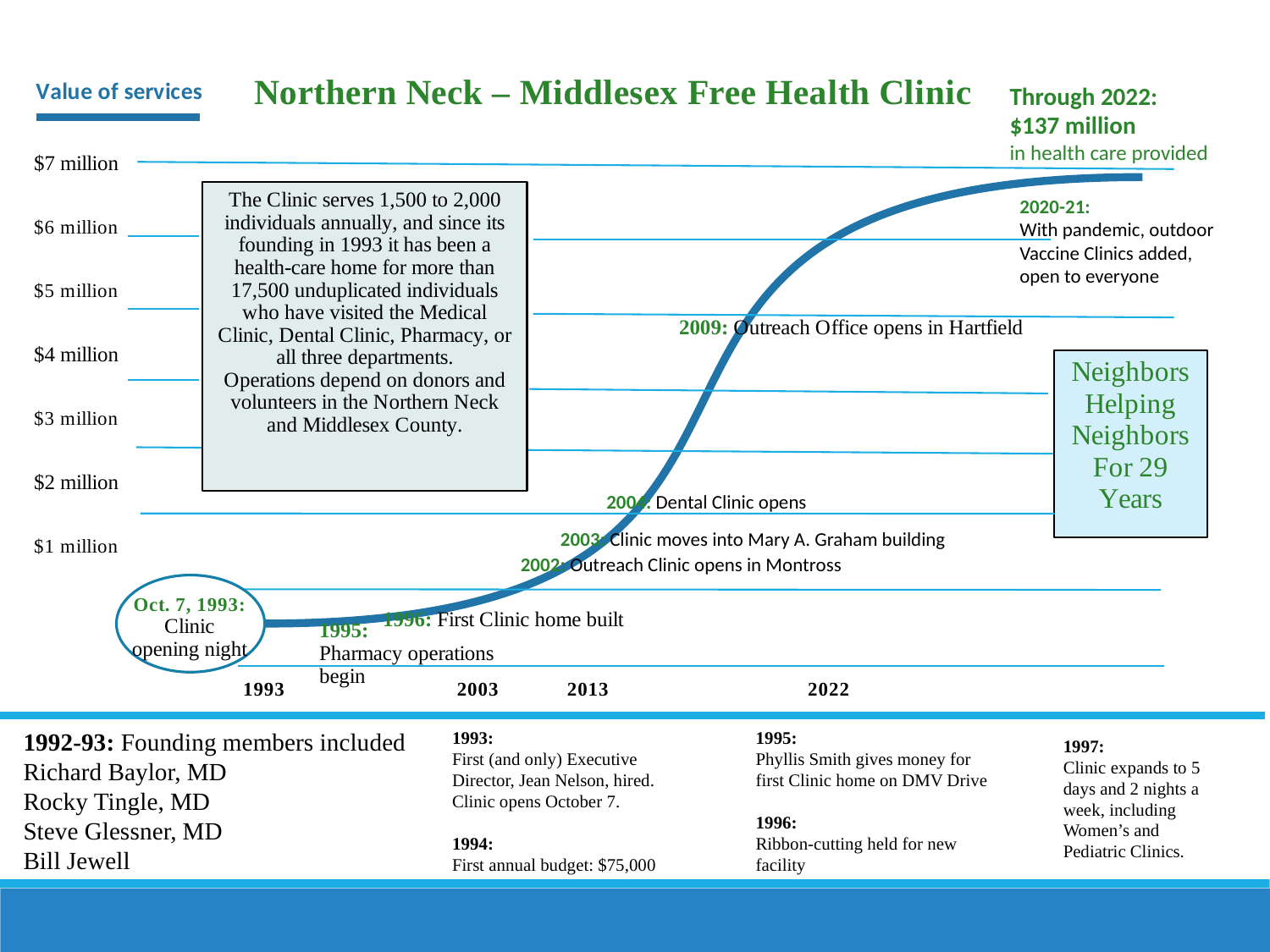
How many lines (series) are plotted on the chart? 1 Is the value of services in 1993 greater or less than $2 million? less Is the value of services higher in 2022 or in 1993? 2022 Is the value of services in 2022 greater or less than $5 million? greater Does the value of services rise or fall from 1993 to 2022? rise Which year on the x axis has the lowest value of services? 1993 Which year on the x axis has the highest value of services? 2022 What is the title of the chart? Northern Neck – Middlesex Free Health Clinic How many year labels are shown along the x axis? 4 What kind of chart is shown on the slide? line chart What is the highest value labelled on the y axis? $7 million